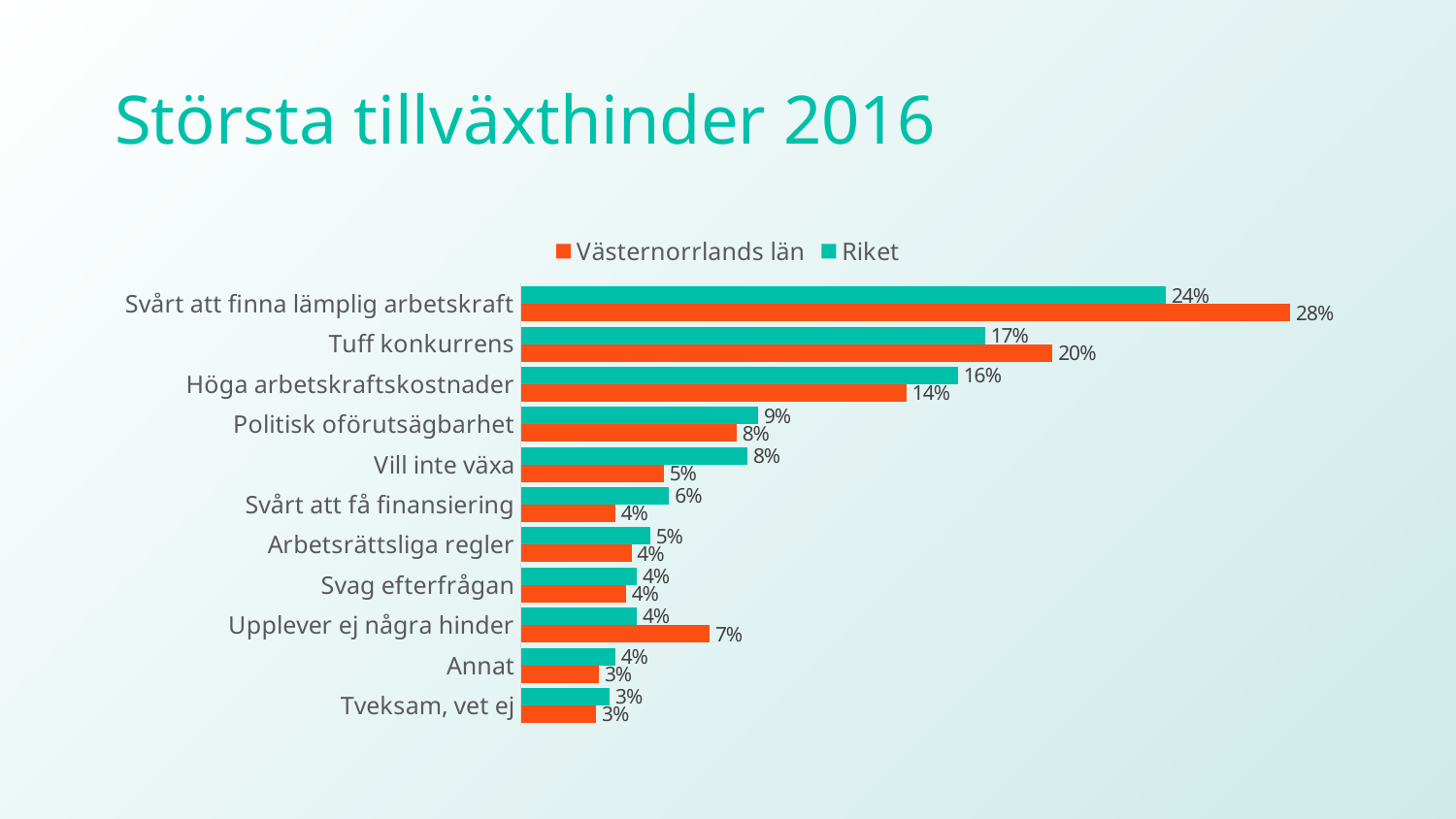
What is the value for Västernorrlands län for 'Svårt att finna lämplig arbetskraft'? 28% What is the value for Riket for 'Tuff konkurrens'? 17% How many series does the legend list? 2 Which category has the lowest value for Västernorrlands län? Annat and Tveksam, vet ej (both 3%) What kind of chart is shown on the slide? Bar chart How many categories are shown in the chart? 11 For 'Tuff konkurrens', which is larger: Västernorrlands län or Riket? Västernorrlands län For 'Höga arbetskraftskostnader', which is larger: Västernorrlands län or Riket? Riket Which category has the highest value for Riket? Svårt att finna lämplig arbetskraft What is the difference between Västernorrlands län and Riket for 'Svårt att finna lämplig arbetskraft'? 4% What is the difference between Riket and Västernorrlands län for 'Vill inte växa'? 3% What is the value for Västernorrlands län for 'Upplever ej några hinder'? 7%